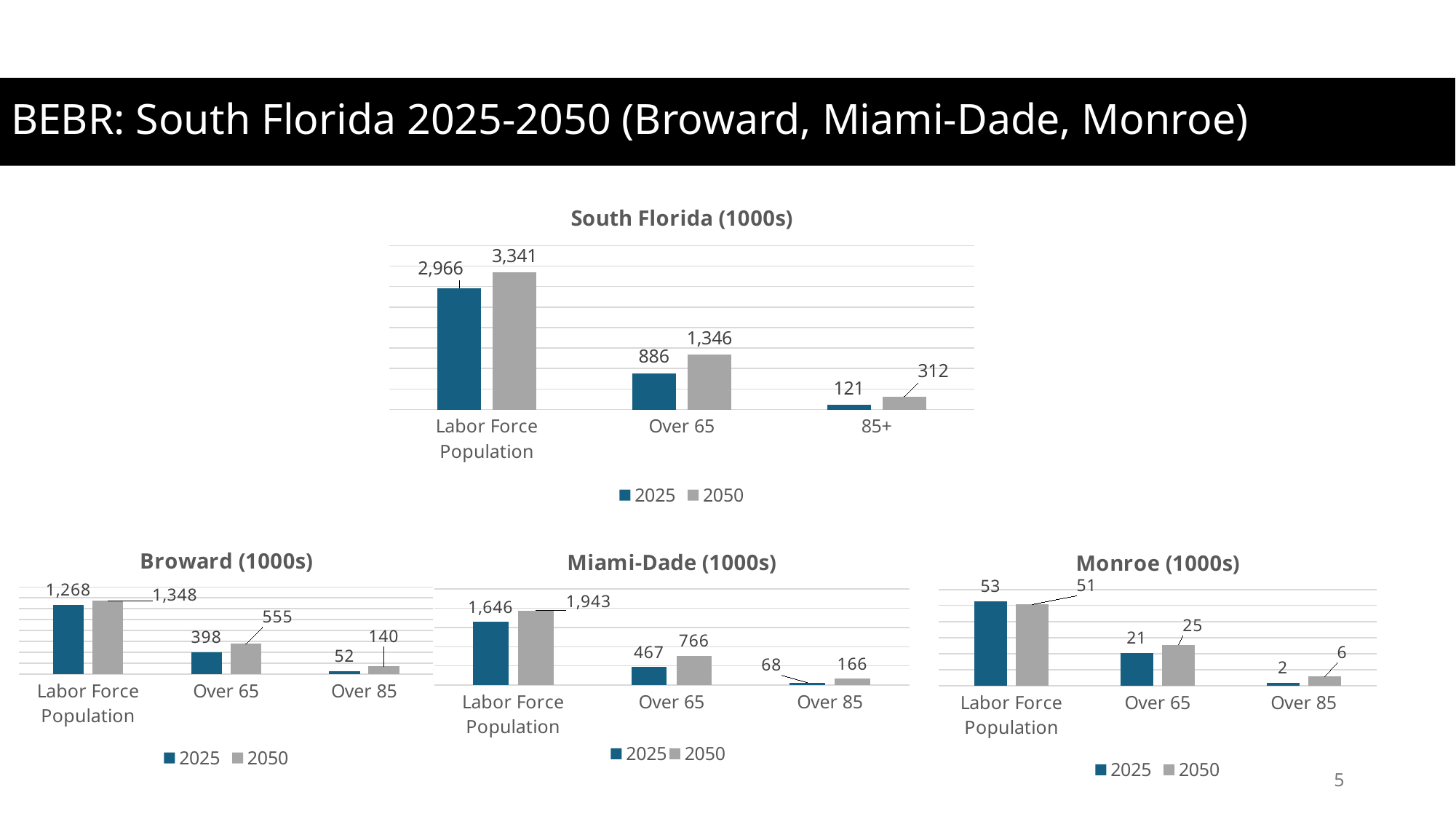
How many categories are shown on the x axis of the Broward (1000s) chart? 3 In the Broward (1000s) chart, which category has the lowest 2025 value? Over 85 In the Monroe (1000s) chart, which is larger for Labor Force Population, the 2025 value or the 2050 value? 2025 In the Miami-Dade (1000s) chart, what is the difference between the 2050 and 2025 values for Over 65? 299 In the South Florida (1000s) chart, what is the 2050 value for Labor Force Population? 3,341 In the South Florida (1000s) chart, what is the difference between the 2050 and 2025 values for 85+? 191 In the Monroe (1000s) chart, what is the 2050 value for Over 85? 6 In the South Florida (1000s) chart, what is the 2025 value for Over 65? 886 How many series does the legend of the South Florida (1000s) chart list? 2 In the Miami-Dade (1000s) chart, what is the 2025 value for Labor Force Population? 1,646 In the Broward (1000s) chart, what is the 2050 value for Over 65? 555 What kind of chart is the Miami-Dade (1000s) chart? Bar chart